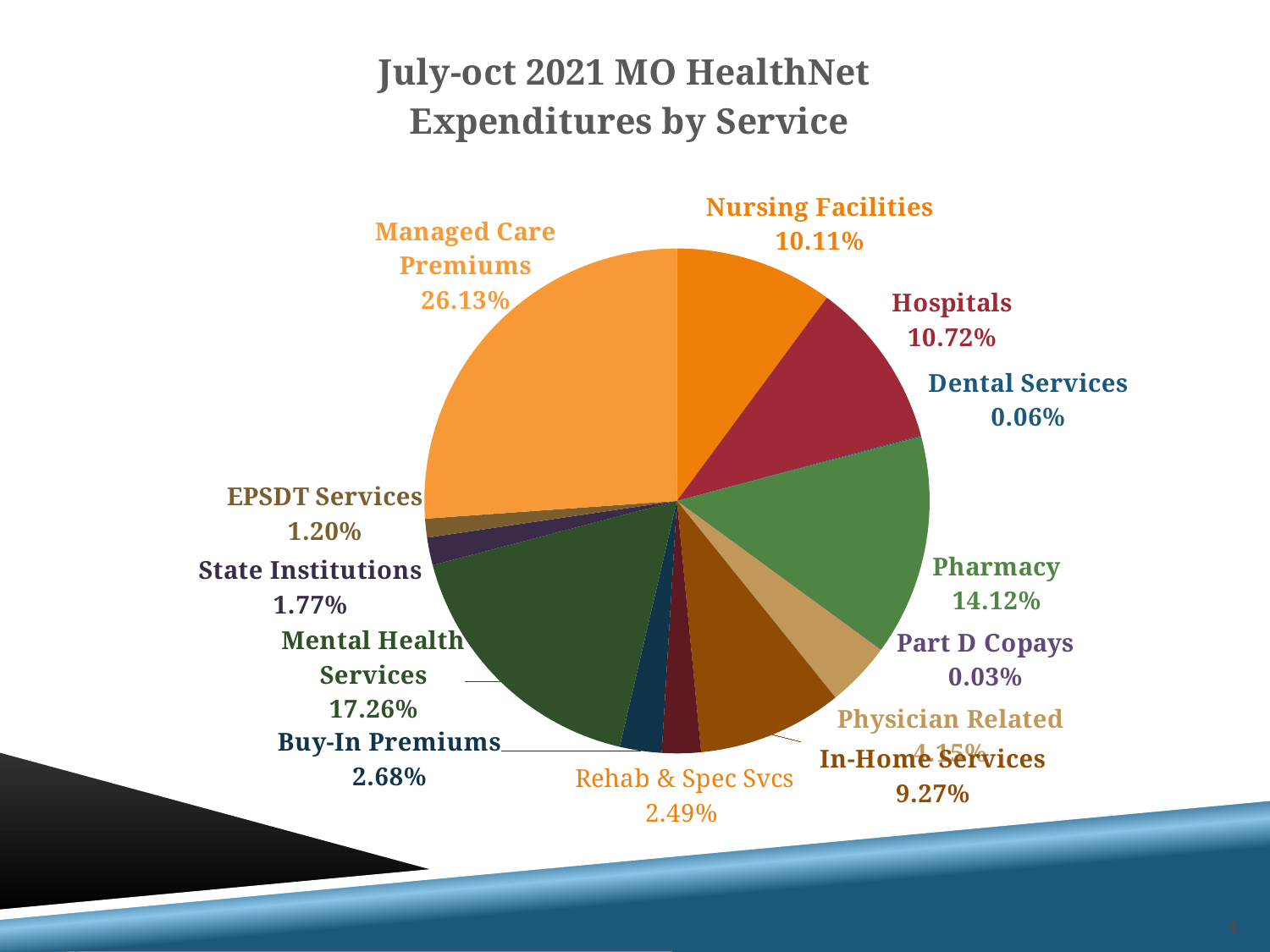
What share of expenditures is Managed Care Premiums? 26.13% Which is larger, Buy-In Premiums or Rehab & Spec Svcs? Buy-In Premiums How many service categories are shown in the pie chart? 13 Which service category has the largest share of expenditures? Managed Care Premiums What is the value for Pharmacy? 14.12% What is the difference between the Hospitals share and the Nursing Facilities share? 0.61% What percentage is shown for Mental Health Services? 17.26% What is the title of the chart? July-oct 2021 MO HealthNet Expenditures by Service Which service category has the smallest share of expenditures? Part D Copays What percentage is shown for In-Home Services? 9.27% What kind of chart is shown on the slide? pie chart What is the value for Dental Services? 0.06%